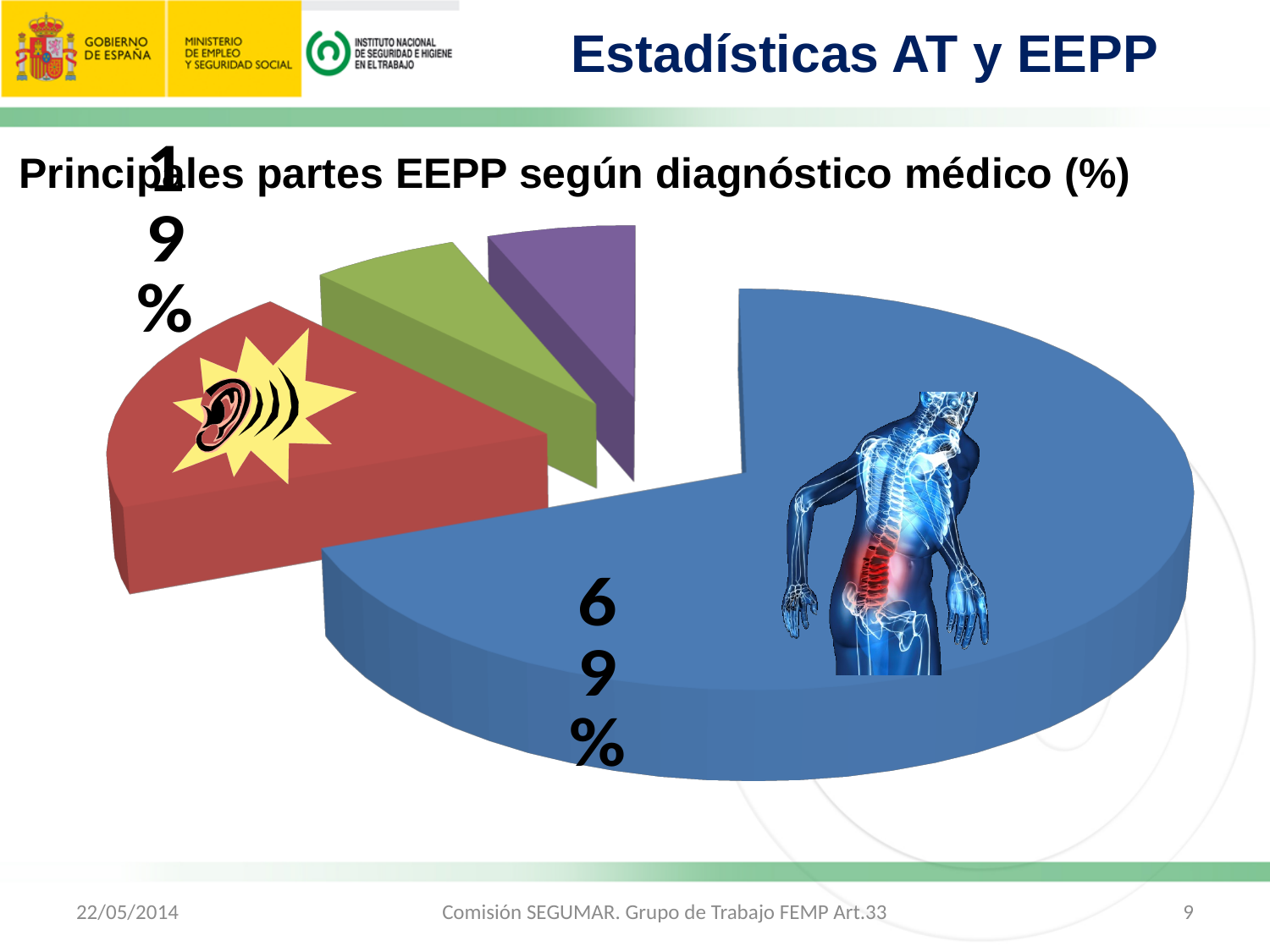
What colour is the slice that contains the image of a spine? blue Which is larger, the green slice or the purple slice? the green slice Which is larger, the blue slice or the red slice? the blue slice What kind of chart is shown on the slide? pie chart What is the difference in percentage points between the blue slice (69%) and the red slice (19%)? 50 What is the title of the chart? Principales partes EEPP según diagnóstico médico (%) What percentage is shown on the large blue slice of the pie chart? 69% What percentage is shown for the red slice with the ear icon? 19% How many slices does the pie chart have? 4 Which slice of the pie chart is the largest? the blue slice (69%)